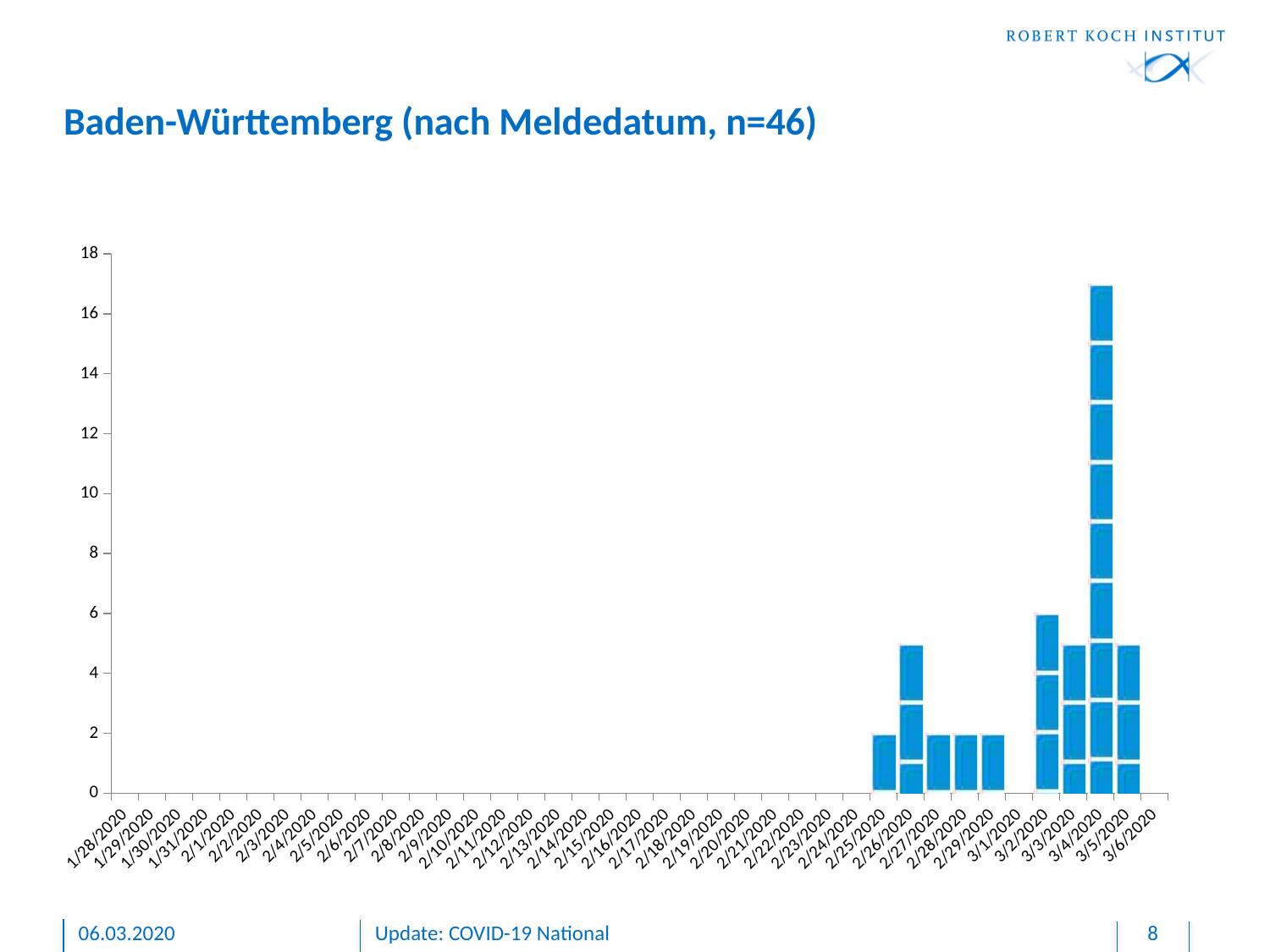
What is the title of the chart? Baden-Württemberg (nach Meldedatum, n=46) Is the value for 2/26/2020 greater or less than 6? less What is the value for 3/2/2020? 6 Is the value for 3/3/2020 greater or less than 4? greater What is the value for 2/25/2020? 2 Which is larger, the value for 3/4/2020 or the value for 3/2/2020? 3/4/2020 What is the value for 2/28/2020? 2 Which date has the highest bar? 3/4/2020 Is the value for 3/4/2020 greater or less than 16? greater What kind of chart is shown on the slide? bar chart What is the difference between the value for 3/2/2020 and the value for 2/25/2020? 4 How many dates have a bar with a value above zero? 9